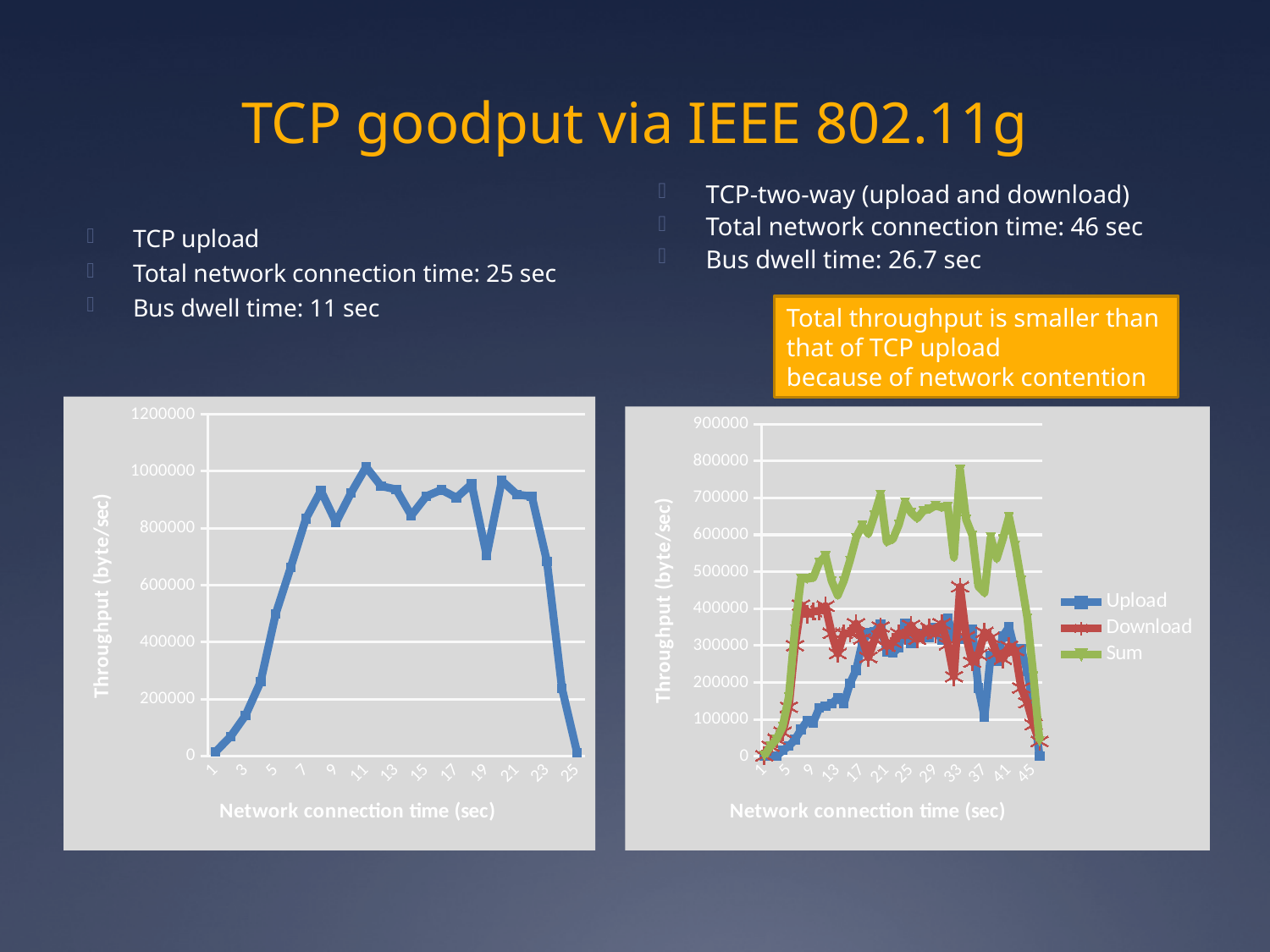
In the right chart, is the Upload value at network connection time 5 sec greater or less than 100000? less In the left chart, does the throughput rise or fall between network connection time 1 sec and 7 sec? rise In the left chart, is the throughput at network connection time 25 sec greater or less than 200000? less In the left chart, is the throughput at network connection time 3 sec greater or less than 400000? less What kind of chart is the left chart on the slide? line chart In the right chart, at network connection time 9 sec, which is larger, the Upload value or the Download value? Download In the right chart, which series has the highest value at network connection time 21 sec? Sum How many series does the legend of the right chart list? 3 What are the series names in the legend of the right chart? Upload, Download, Sum What is the y-axis title of the left chart? Throughput (byte/sec)